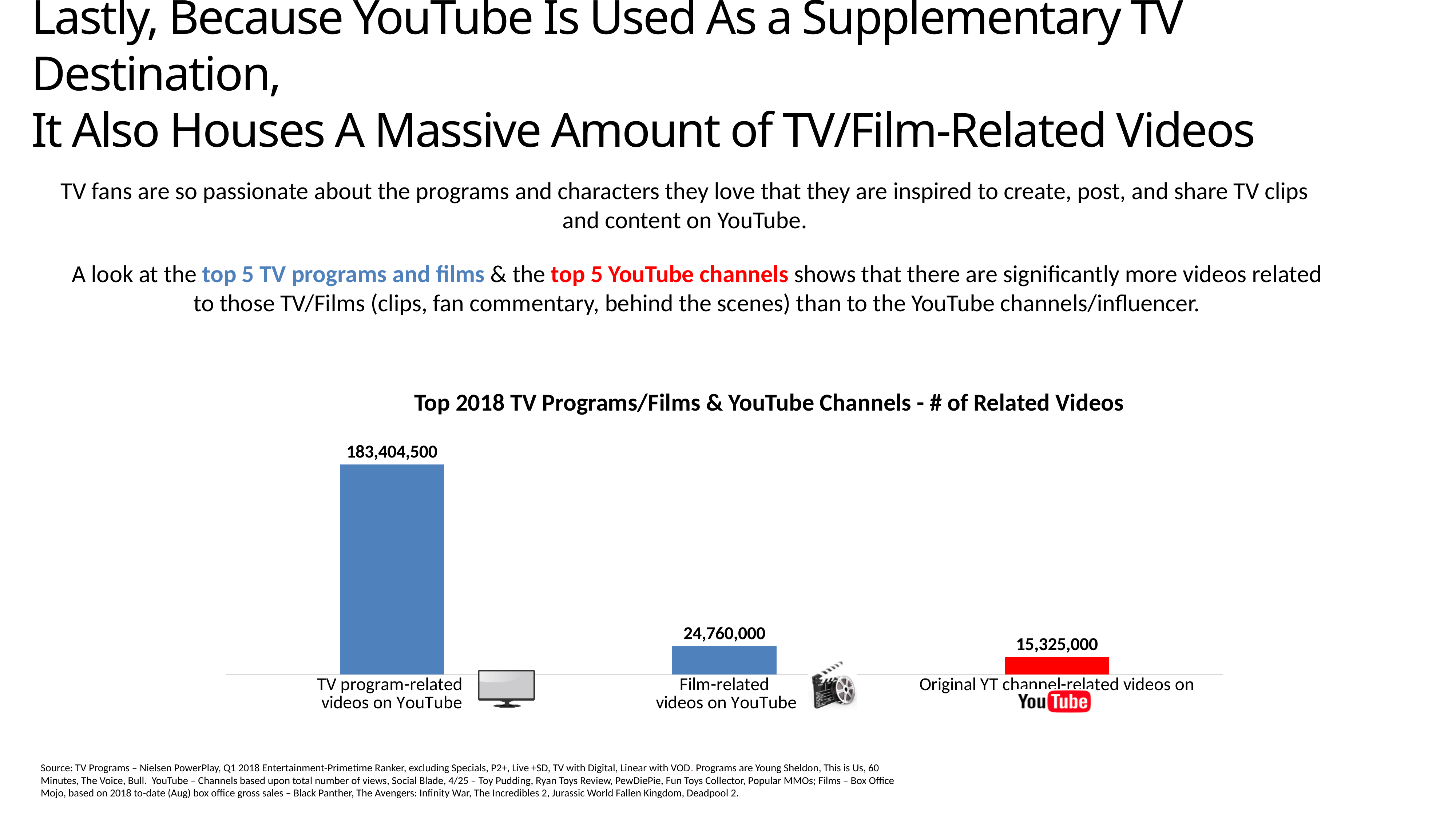
What colour is the bar for Original YT channel-related videos on YouTube? Red What is the value for TV program-related videos on YouTube? 183,404,500 How many categories are shown in the chart? 3 What kind of chart is shown on the slide? Bar chart Which category has the lowest number of related videos? Original YT channel-related videos on YouTube Which is larger: Film-related videos on YouTube or Original YT channel-related videos on YouTube? Film-related videos on YouTube What is the title of the chart? Top 2018 TV Programs/Films & YouTube Channels - # of Related Videos What is the value for Original YT channel-related videos on YouTube? 15,325,000 What is the value for Film-related videos on YouTube? 24,760,000 What is the difference between TV program-related videos and Film-related videos on YouTube? 158,644,500 What is the difference between Film-related videos and Original YT channel-related videos on YouTube? 9,435,000 Which category has the highest number of related videos? TV program-related videos on YouTube